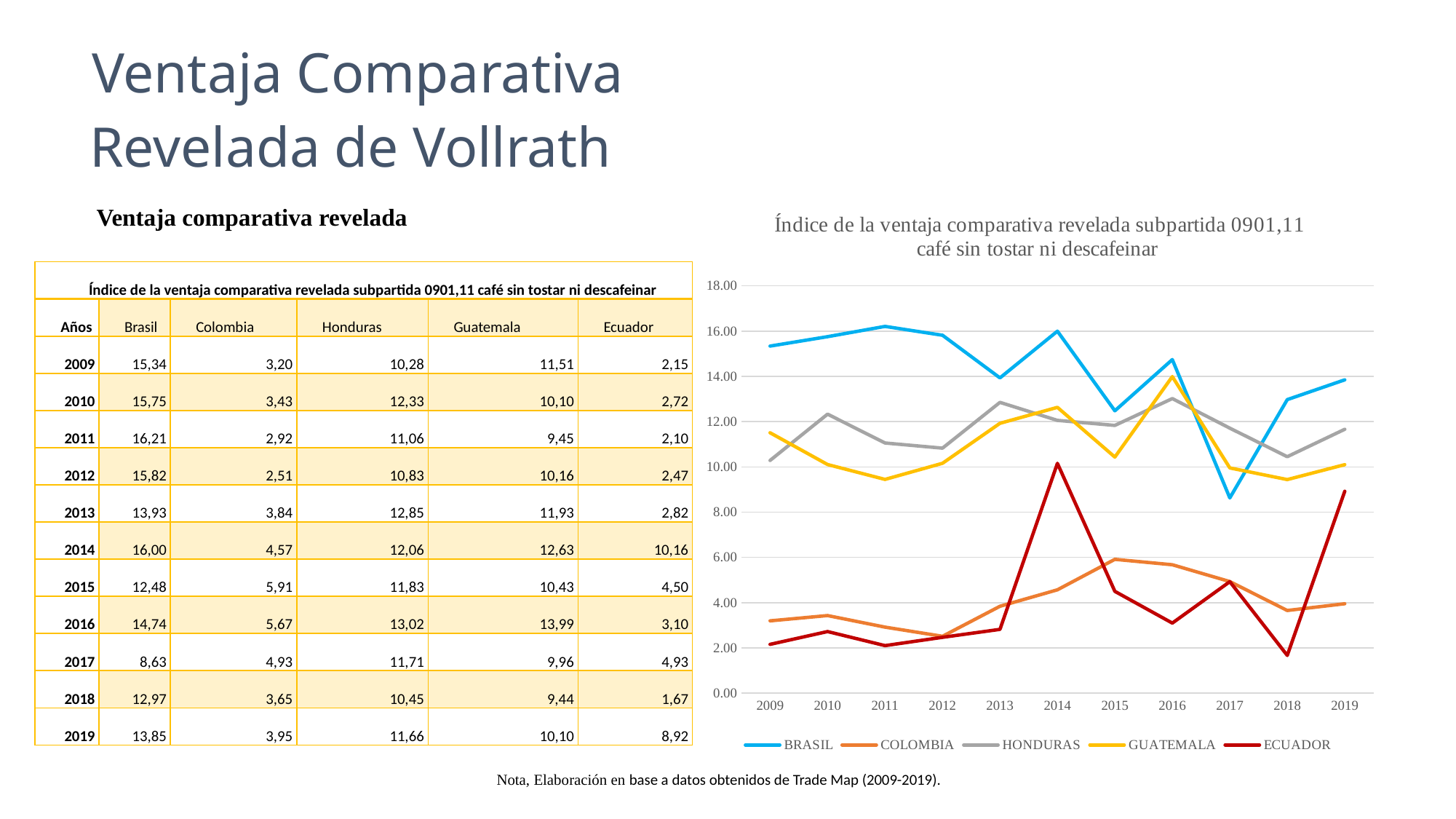
Does the Ecuador line rise or fall from 2018 to 2019? rise How many series does the chart's legend list? 5 Is the value for Brasil in 2017 greater or less than 10.00? less In which year does Ecuador have its lowest index value? 2018 What is the index value for Brasil in 2011? 16,21 What is the index value for Ecuador in 2014? 10,16 What is the difference between the Brasil and Colombia values in 2019? 9,90 What kind of chart is shown on the slide? line chart In which year does Brasil reach its highest index value? 2011 In 2016, which is larger: the value for Guatemala or the value for Honduras? Guatemala Which colour is used for the Ecuador line in the chart? dark red How many years are plotted along the x axis of the chart? 11